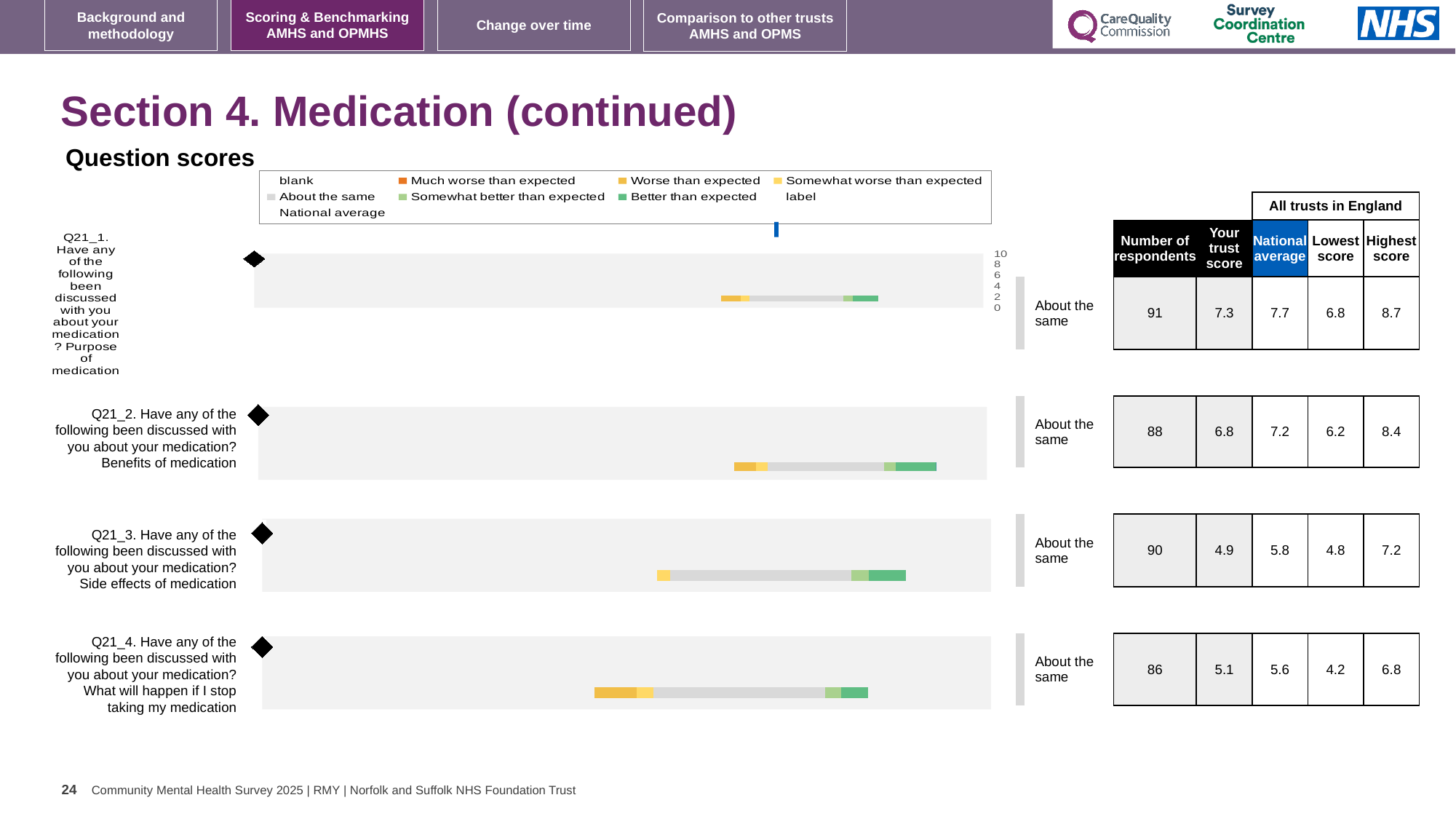
What kind of chart is used to show the question scores for Q21_1 to Q21_4? bar chart In the table next to the charts, how many respondents answered Q21_4 (What will happen if I stop taking my medication)? 86 Which of the four questions (Q21_1 to Q21_4) has the lowest national average in the table? Q21_4 Which of the four questions (Q21_1 to Q21_4) has the highest trust score in the table? Q21_1 Which legend entry is shown in dark green in the chart legend? Better than expected What is the difference between the national average and the trust score for Q21_3 (Side effects of medication)? 0.9 In the table next to the charts, what is the trust score for Q21_2 (Benefits of medication)? 6.8 In the table next to the charts, what is the highest score among all trusts in England for Q21_1 (Purpose of medication)? 8.7 Is the trust score for Q21_2 (Benefits of medication) larger or smaller than the national average for that question? smaller What benchmark category label is shown to the right of each of the four charts? About the same How many question score charts (Q21_1 to Q21_4) are shown on the slide? 4 In the table next to the charts, what is the national average for Q21_3 (Side effects of medication)? 5.8